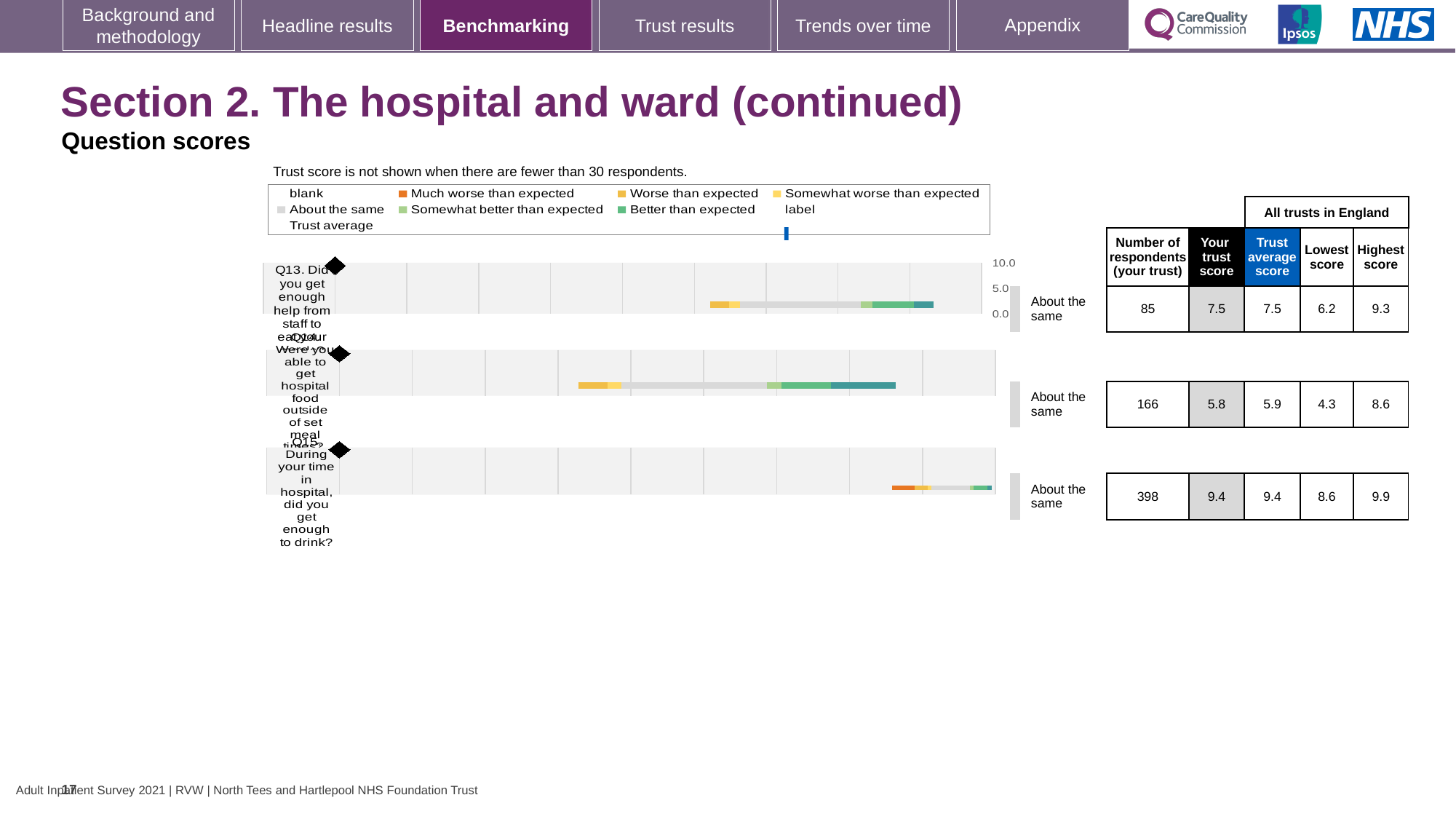
How many questions are plotted in the benchmarking chart? 3 What is the difference between the trust scores for Q15 (9.4) and Q14 (5.8)? 3.6 How many respondents answered Q15 (did you get enough to drink) at this trust? 398 Which question has the lowest trust score? Q14 What kind of chart is used to show the question scores for Q13, Q14 and Q15? bar chart For Q14, which is larger: the trust score or the trust average score? Trust average score (5.9) What benchmark category is shown for Q14 (able to get hospital food outside of set meal times)? About the same Is the trust average marker for Q15 greater or less than 5.0 on the score axis? greater Which question has the highest trust score? Q15 What is the trust score for Q13 (Did you get enough help from staff to eat your meals)? 7.5 What is the difference between the highest score (9.9) and the lowest score (8.6) across all trusts in England for Q15? 1.3 What is the lowest score across all trusts in England for Q14? 4.3